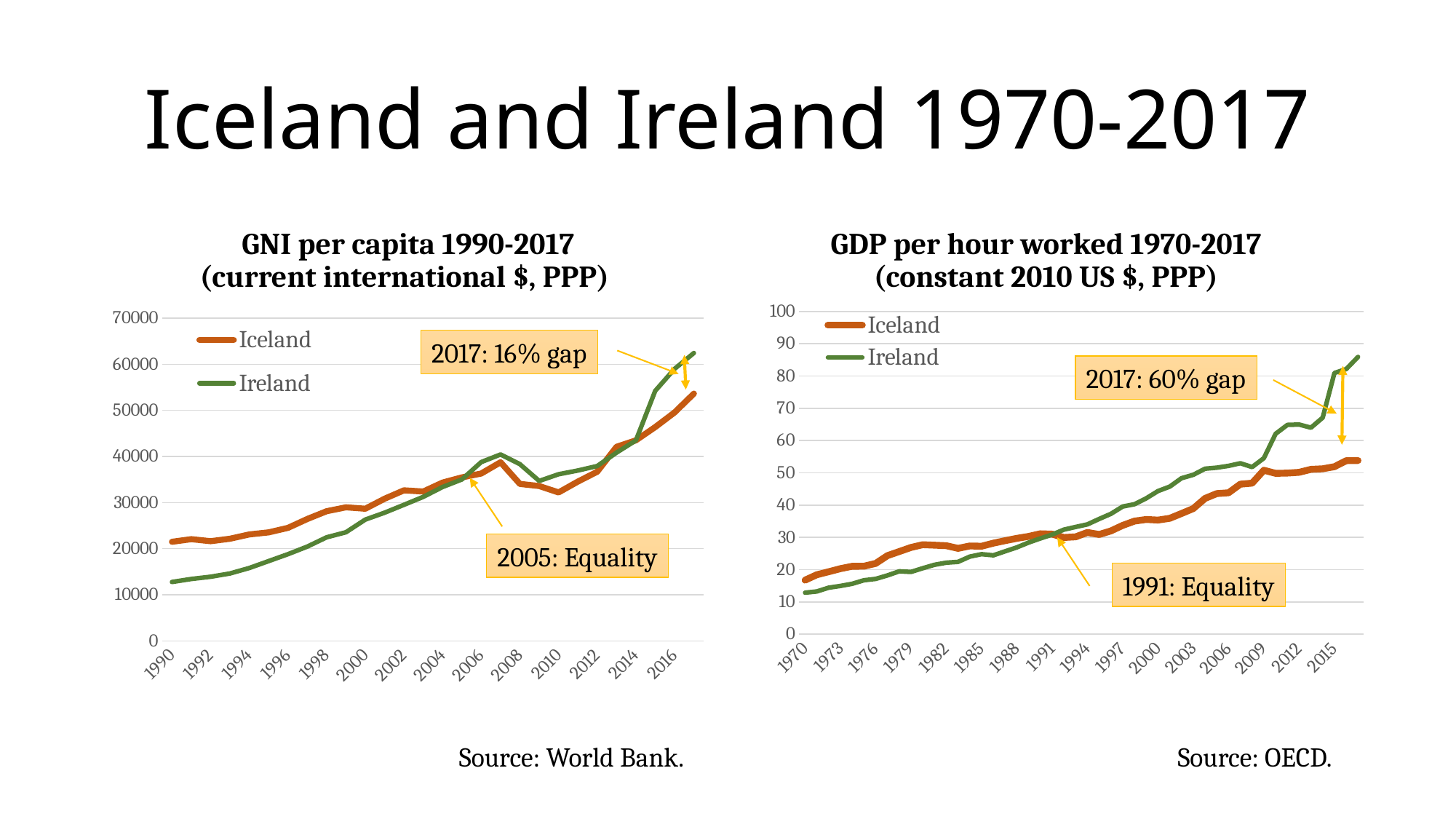
How many series does the legend of the GDP per hour worked 1970-2017 chart list? 2 In the GNI per capita 1990-2017 chart, is the value for Iceland in 2016 greater or less than 40000? greater According to the annotation on the GNI per capita 1990-2017 chart, what is the gap between the two countries in 2017? 16% gap In the GNI per capita 1990-2017 chart, which country has the higher value in 2017, Iceland or Ireland? Ireland In the GNI per capita 1990-2017 chart, which country has the higher value in 1990, Iceland or Ireland? Iceland In the GDP per hour worked 1970-2017 chart, is the value for Iceland in 1970 greater or less than 20? less What kind of chart is the GNI per capita 1990-2017 chart? Line chart In the GDP per hour worked 1970-2017 chart, which country has the higher value in 2017, Iceland or Ireland? Ireland In the GNI per capita 1990-2017 chart, is the value for Ireland in 1990 greater or less than 20000? less In the GDP per hour worked 1970-2017 chart, do the values for Ireland generally rise or fall from 1970 to 2017? Rise According to the annotation on the GDP per hour worked 1970-2017 chart, in which year were the two countries equal? 1991